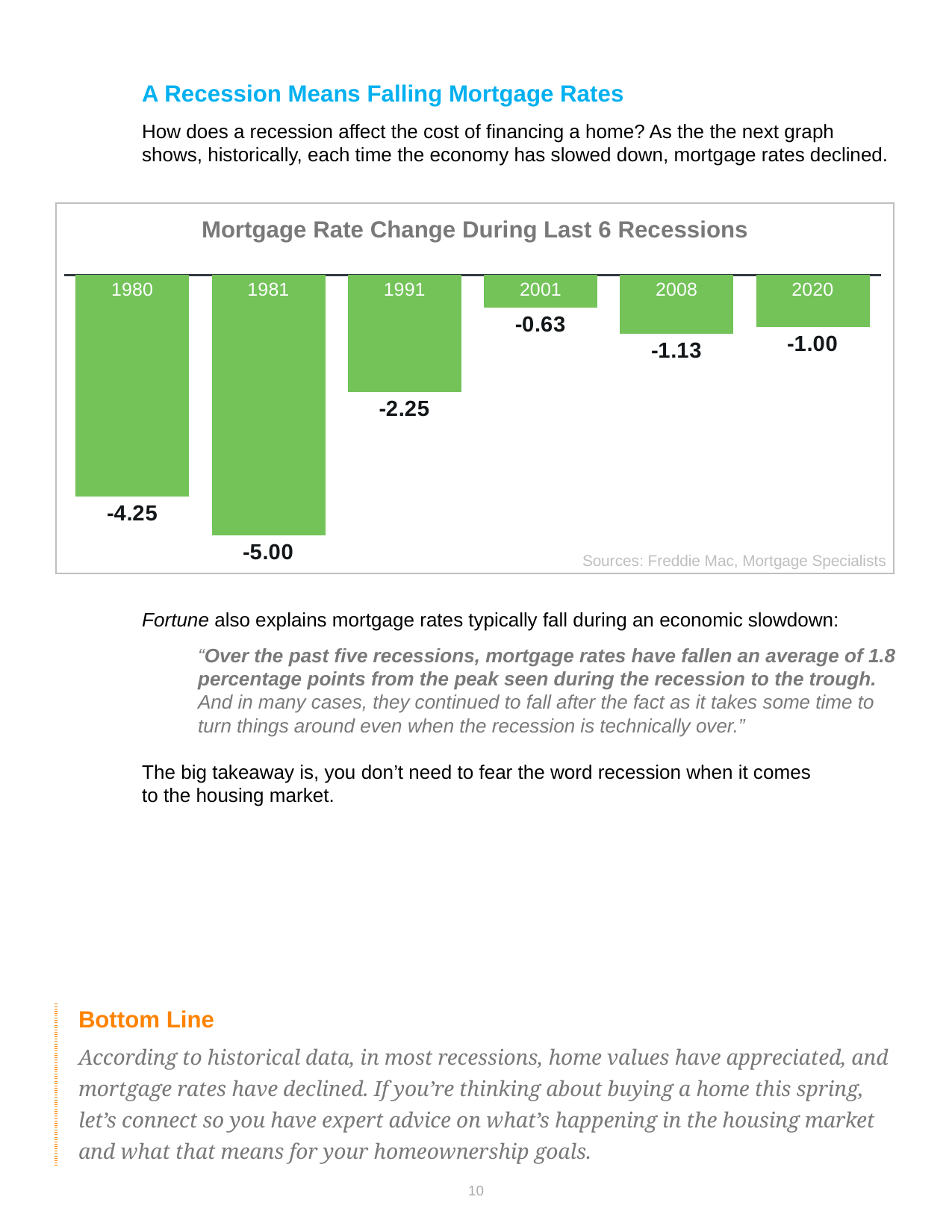
What is the difference between the mortgage rate changes for 2008 and 2020? 0.13 Which recession shows the largest decline in mortgage rates? 1981 What is the mortgage rate change shown for the 2020 recession? -1.00 How many recessions are shown in the chart? 6 Which recession had a larger mortgage rate decline, 1980 or 1991? 1980 What is the mortgage rate change shown for the 2001 recession? -0.63 What is the title of the chart? Mortgage Rate Change During Last 6 Recessions By how much does the mortgage rate decline in 1981 exceed the decline in 1980? 0.75 Which recession shows the smallest decline in mortgage rates? 2001 What is the mortgage rate change shown for the 2008 recession? -1.13 What type of chart is used to show the mortgage rate changes? Bar chart What is the mortgage rate change shown for the 1981 recession? -5.00